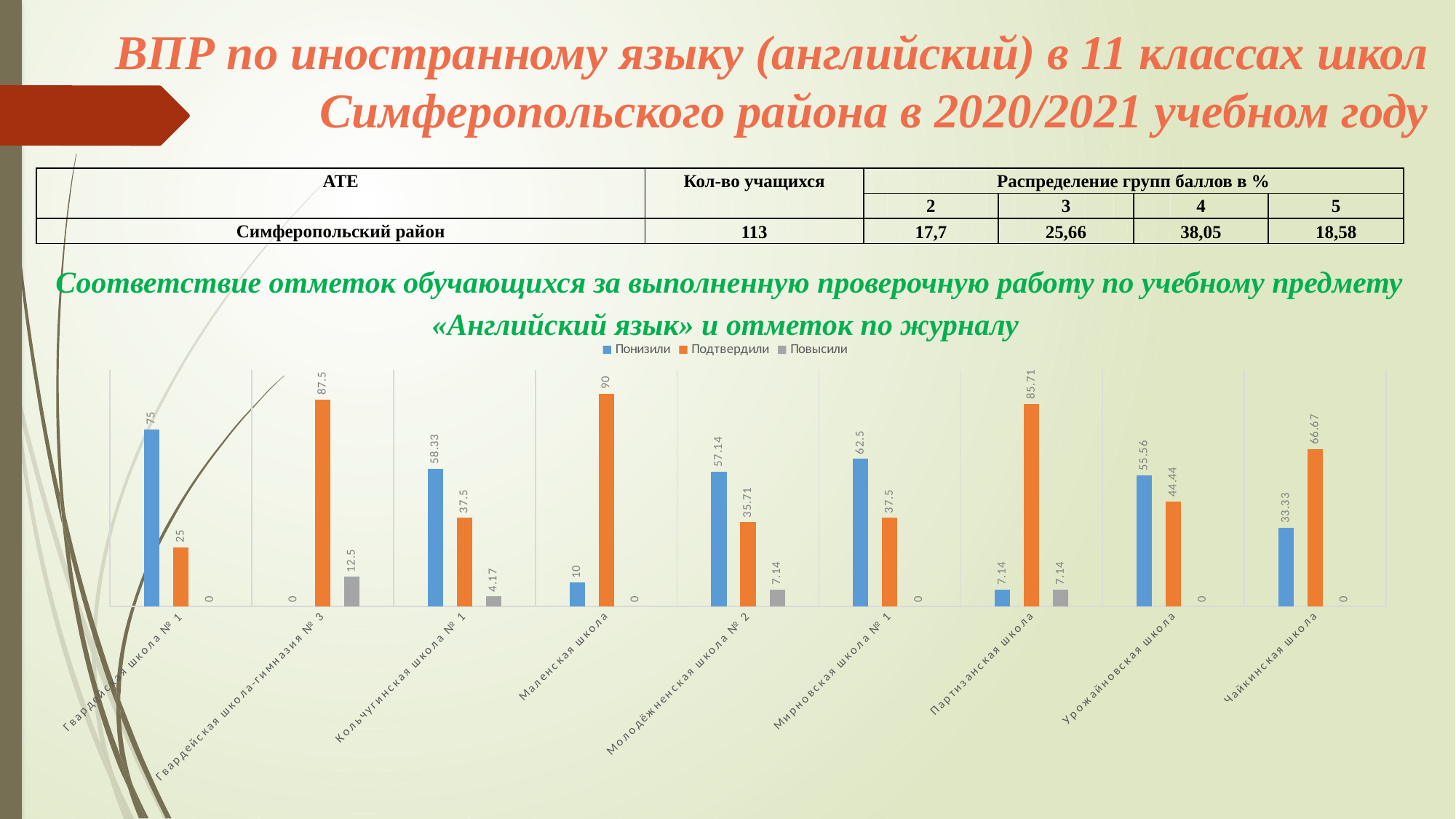
How many schools are shown on the x axis of the chart? 9 Which is larger for Урожайновская школа: Понизили or Подтвердили? Понизили Which school has the lowest value of Понизили? Гвардейская школа-гимназия № 3 What is the difference between Понизили and Подтвердили for Гвардейская школа № 1? 50 What is the value of Подтвердили for Партизанская школа? 85.71 What kind of chart is shown on the slide? Bar chart Which school has the highest value of Подтвердили? Маленская школа Which colour represents the Повысили series in the chart? Gray What is the value of Понизили for Гвардейская школа № 1? 75 What is the value of Подтвердили for Маленская школа? 90 How many series does the chart legend list? 3 What is the value of Повысили for Гвардейская школа-гимназия № 3? 12.5